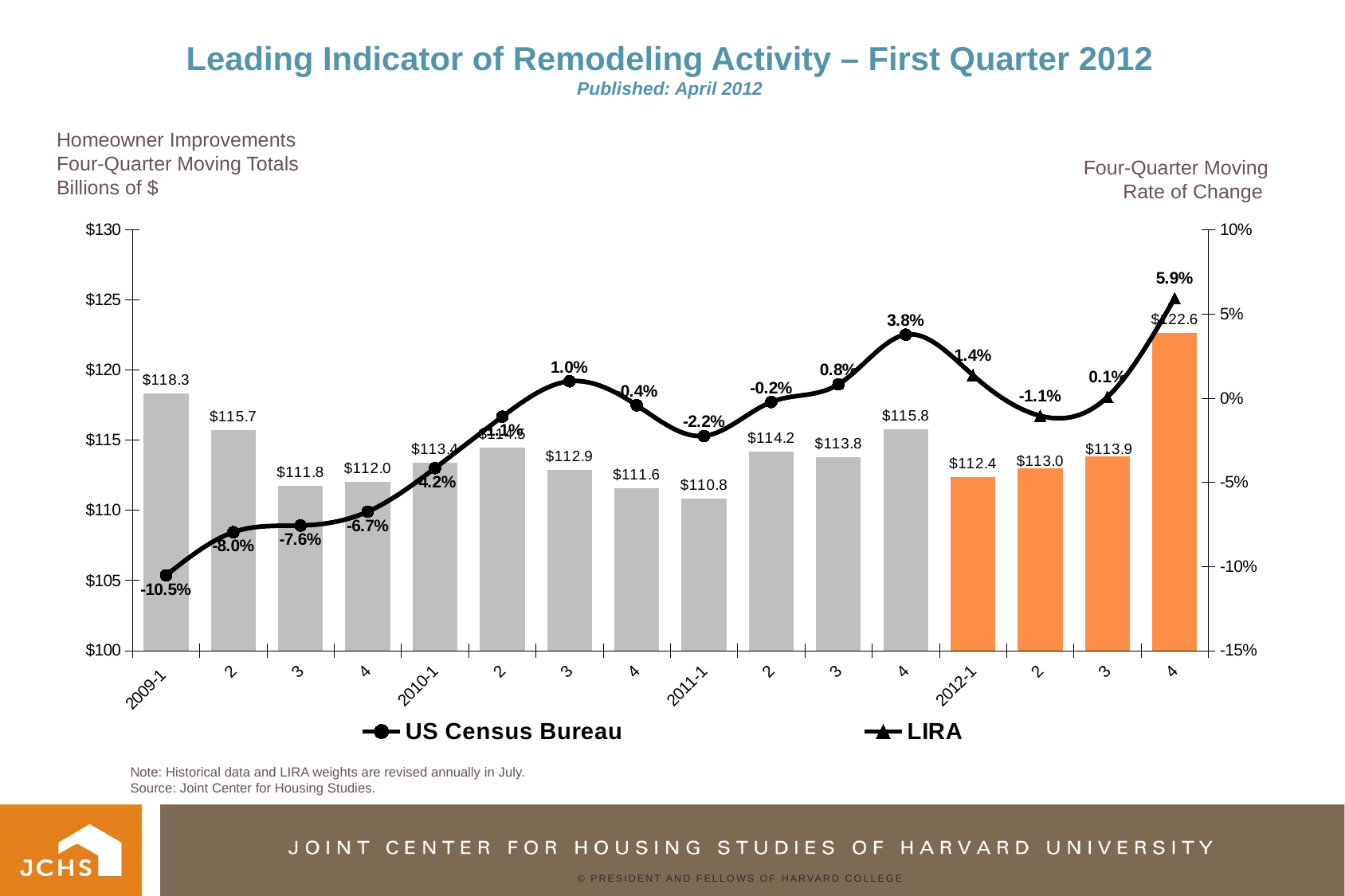
Which quarter has the highest four-quarter moving rate of change? 2012-4 What is the difference between the four-quarter moving totals for 2009-1 and 2009-2? $2.6 What is the four-quarter moving rate of change for 2011-4? 3.8% How many quarters are plotted as bars on the chart? 16 How many series does the legend list? 2 What is the four-quarter moving rate of change for 2009-1? -10.5% What are the two series named in the legend? US Census Bureau and LIRA Which quarter has the highest four-quarter moving total bar? 2012-4 Which is larger, the four-quarter moving total for 2011-4 or for 2012-1? 2011-4 What is the four-quarter moving total for 2011-1? $110.8 Which quarter has the lowest four-quarter moving total bar? 2011-1 What is the four-quarter moving total for 2009-1? $118.3